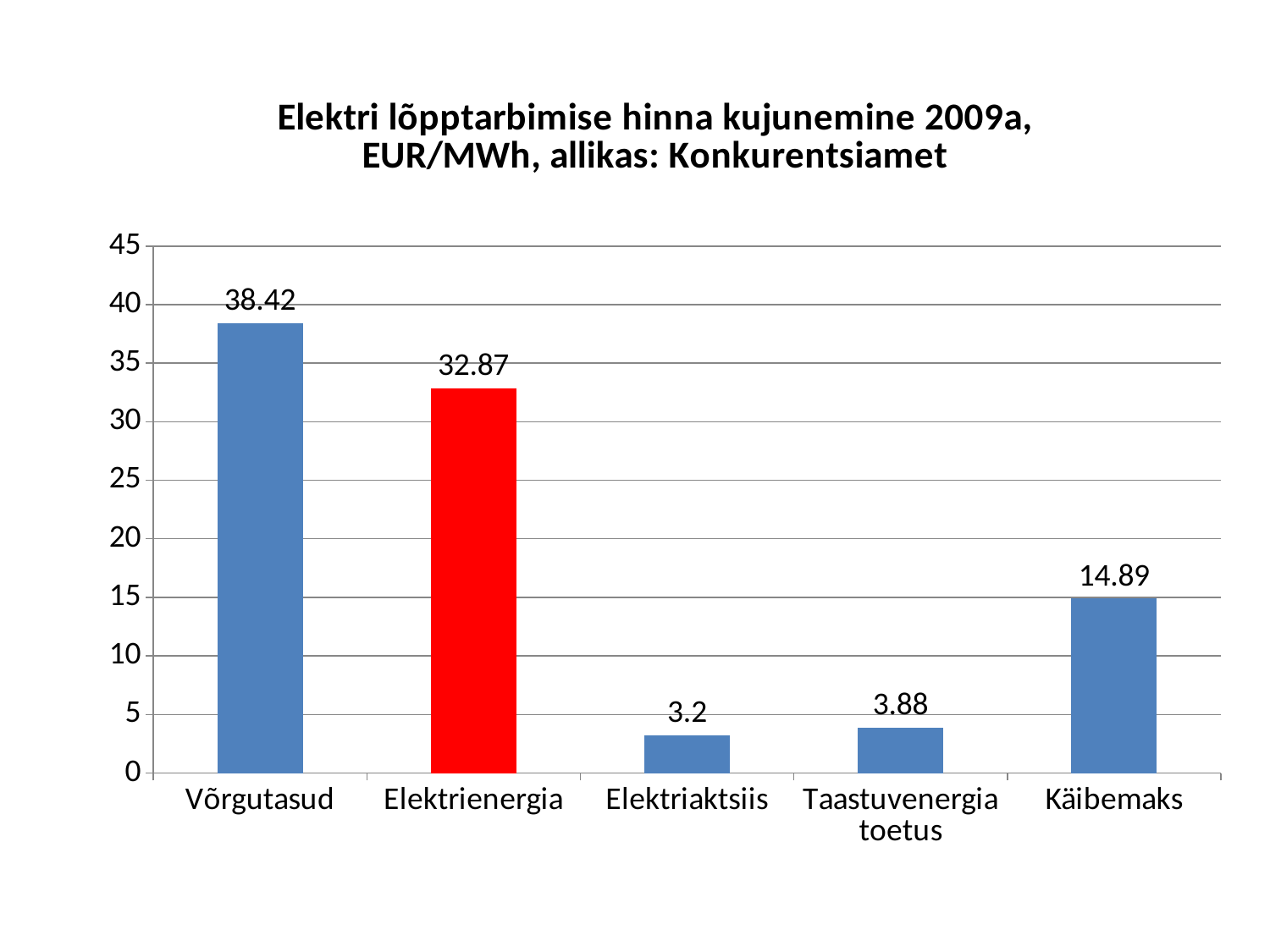
Which category has the lowest value? Elektriaktsiis Which category has the highest value? Võrgutasud Which bar is coloured red? Elektrienergia Which is larger, the value for Käibemaks or the value for Taastuvenergia toetus? Käibemaks What is the value for Taastuvenergia toetus? 3.88 How many categories are shown on the x axis? 5 What is the value for Elektrienergia? 32.87 What is the value for Võrgutasud? 38.42 Is the value for Elektrienergia greater or less than 30? greater What kind of chart is shown on the slide? bar chart What is the difference between the values for Võrgutasud and Elektrienergia? 5.55 What is the value for Käibemaks? 14.89